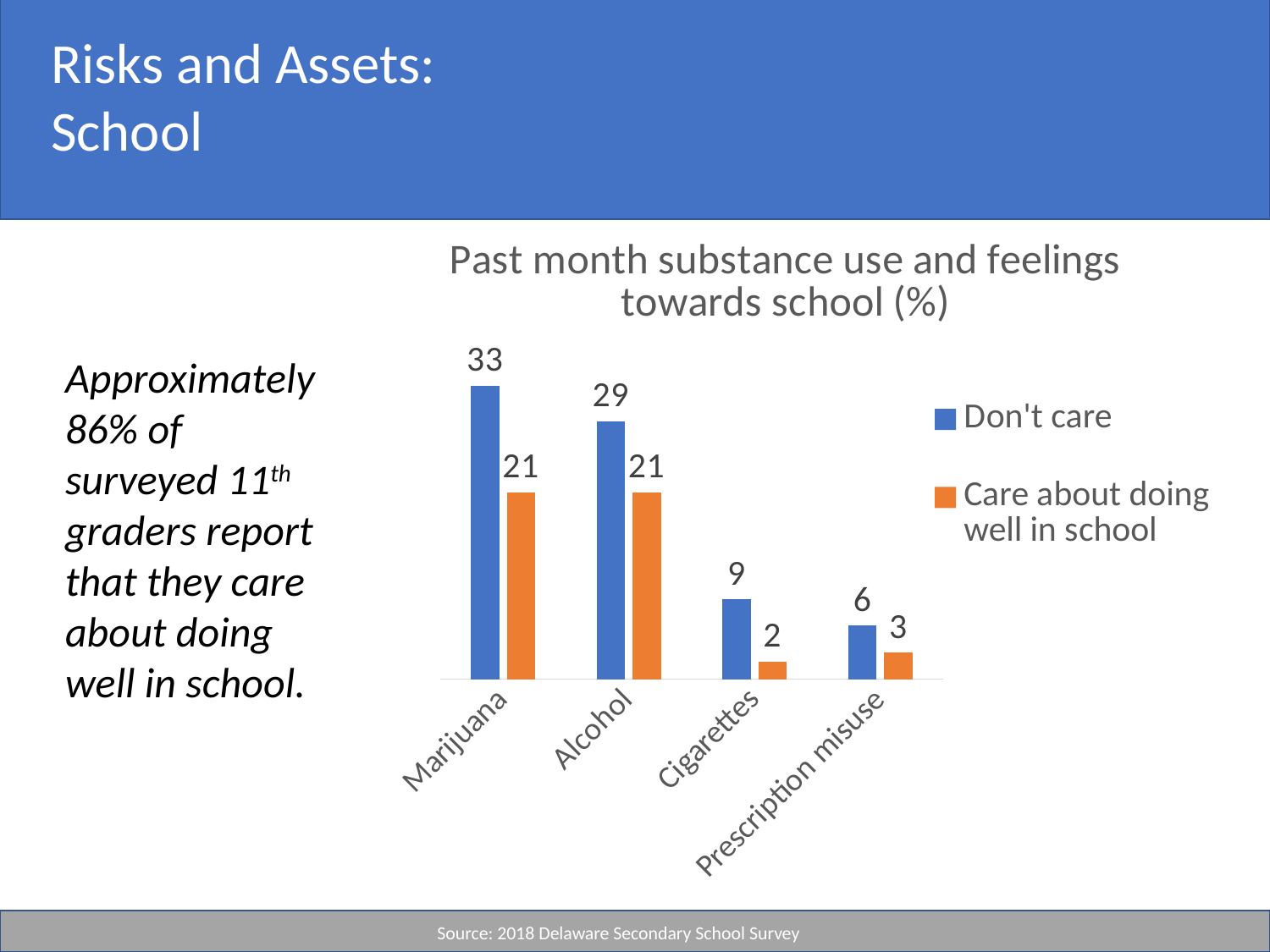
What is the value for Cigarettes in the Don't care series? 9 How many categories are shown on the x axis? 4 What kind of chart is shown on the slide? Bar chart What is the title of the chart? Past month substance use and feelings towards school (%) Which category has the lowest value in the Care about doing well in school series? Cigarettes What is the value for Prescription misuse in the Care about doing well in school series? 3 What is the difference between the Don't care and Care about doing well in school values for Marijuana? 12 What is the value for Marijuana in the Don't care series? 33 How many series does the legend list? 2 Which is larger for Prescription misuse: the Don't care value or the Care about doing well in school value? Don't care What is the value for Alcohol in the Care about doing well in school series? 21 Which category has the highest value in the Don't care series? Marijuana